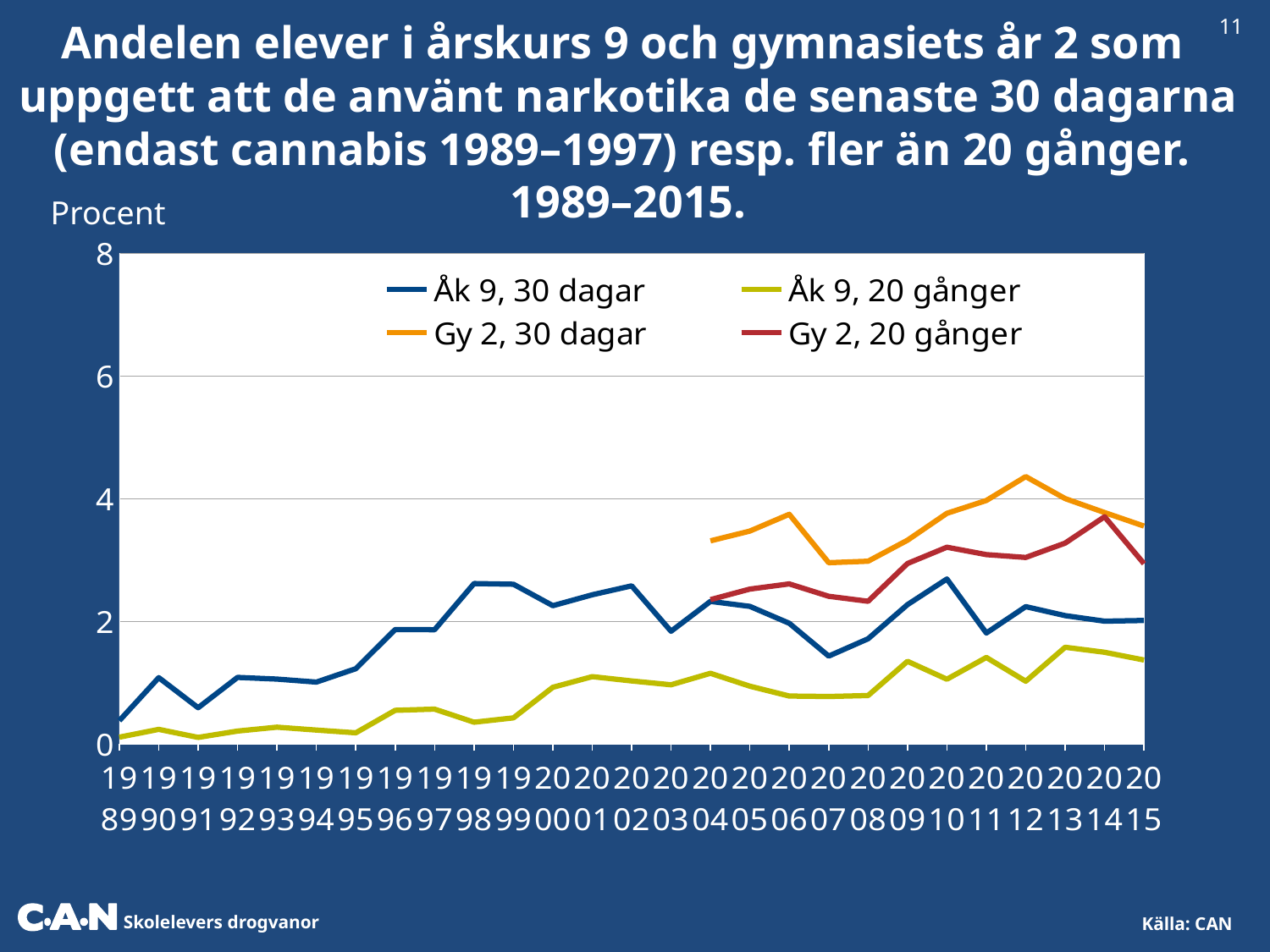
How many series does the legend list? 4 In 2000, which is larger: Åk 9, 30 dagar or Åk 9, 20 gånger? Åk 9, 30 dagar What kind of chart is shown on the slide? line chart Does the Gy 2, 30 dagar series rise or fall from 2012 to 2015? fall In which year does the Gy 2, 30 dagar series reach its highest value? 2012 Is the value for Åk 9, 20 gånger in 2015 greater or less than 2? less How many years are plotted along the x axis? 27 Is the value for Gy 2, 30 dagar in 2012 greater or less than 4? greater What is the label shown on the y axis of the chart? Procent Is the value for Åk 9, 30 dagar in 1989 greater or less than 2? less Which series has the highest value in 2012? Gy 2, 30 dagar